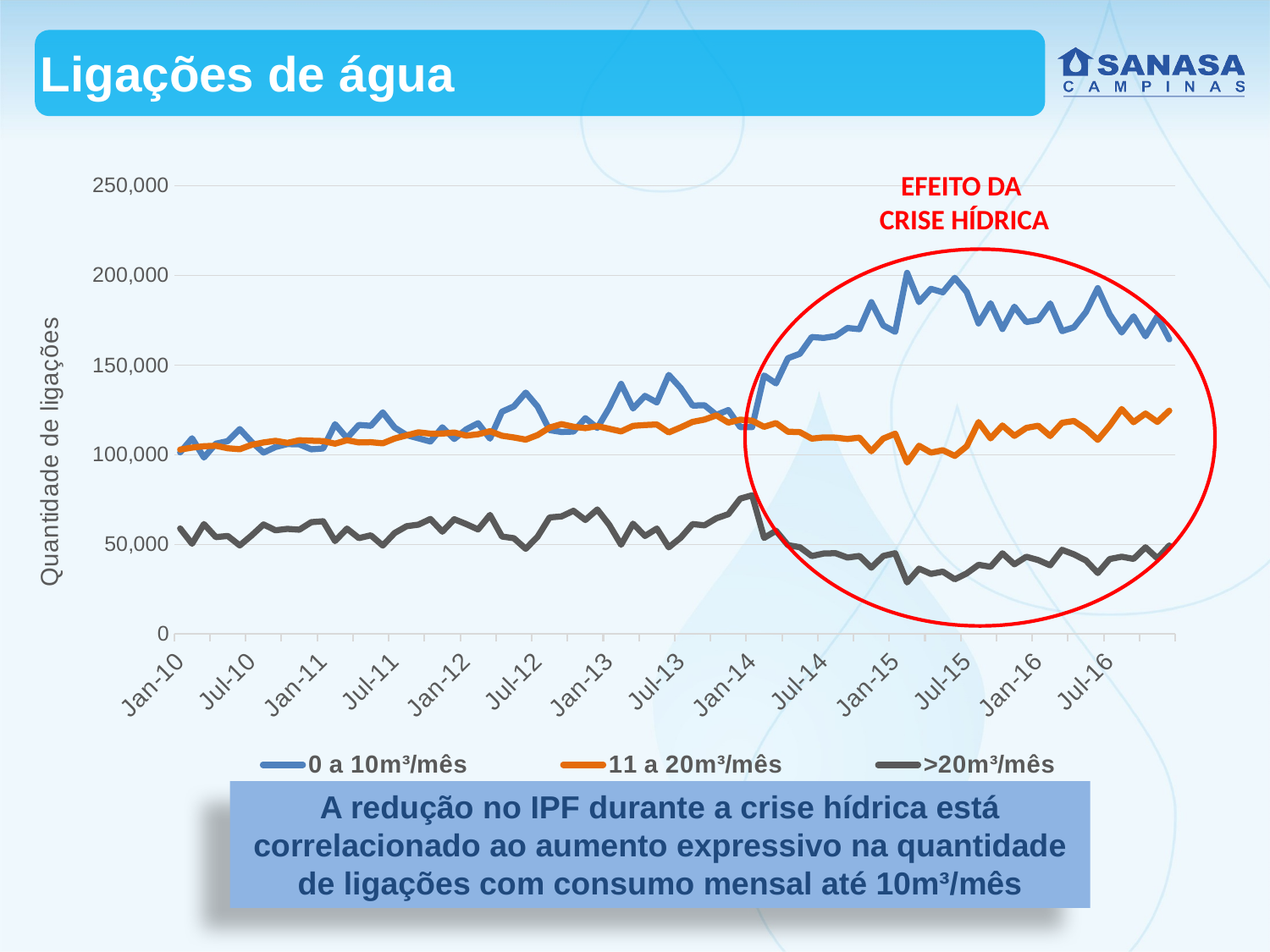
Is the value for the ">20m³/mês" series at Jul-15 greater or less than 50,000? less What are the three series named in the chart legend? 0 a 10m³/mês, 11 a 20m³/mês, >20m³/mês What is the label on the vertical axis of the chart? Quantidade de ligações Which series has the lowest value at Jul-12? >20m³/mês Does the ">20m³/mês" series rise or fall between Jan-14 and Jan-15? fall Is the value for the "0 a 10m³/mês" series at Jan-15 greater or less than 150,000? greater Is the value for the "11 a 20m³/mês" series at Jan-10 greater or less than 150,000? less What kind of chart is shown on the slide? line chart Which series has the highest value at Jan-16? 0 a 10m³/mês How many series does the chart legend list? 3 At Jul-16, which series has the higher value: "0 a 10m³/mês" or ">20m³/mês"? 0 a 10m³/mês Does the "0 a 10m³/mês" series rise or fall between Jan-14 and Jan-15? rise